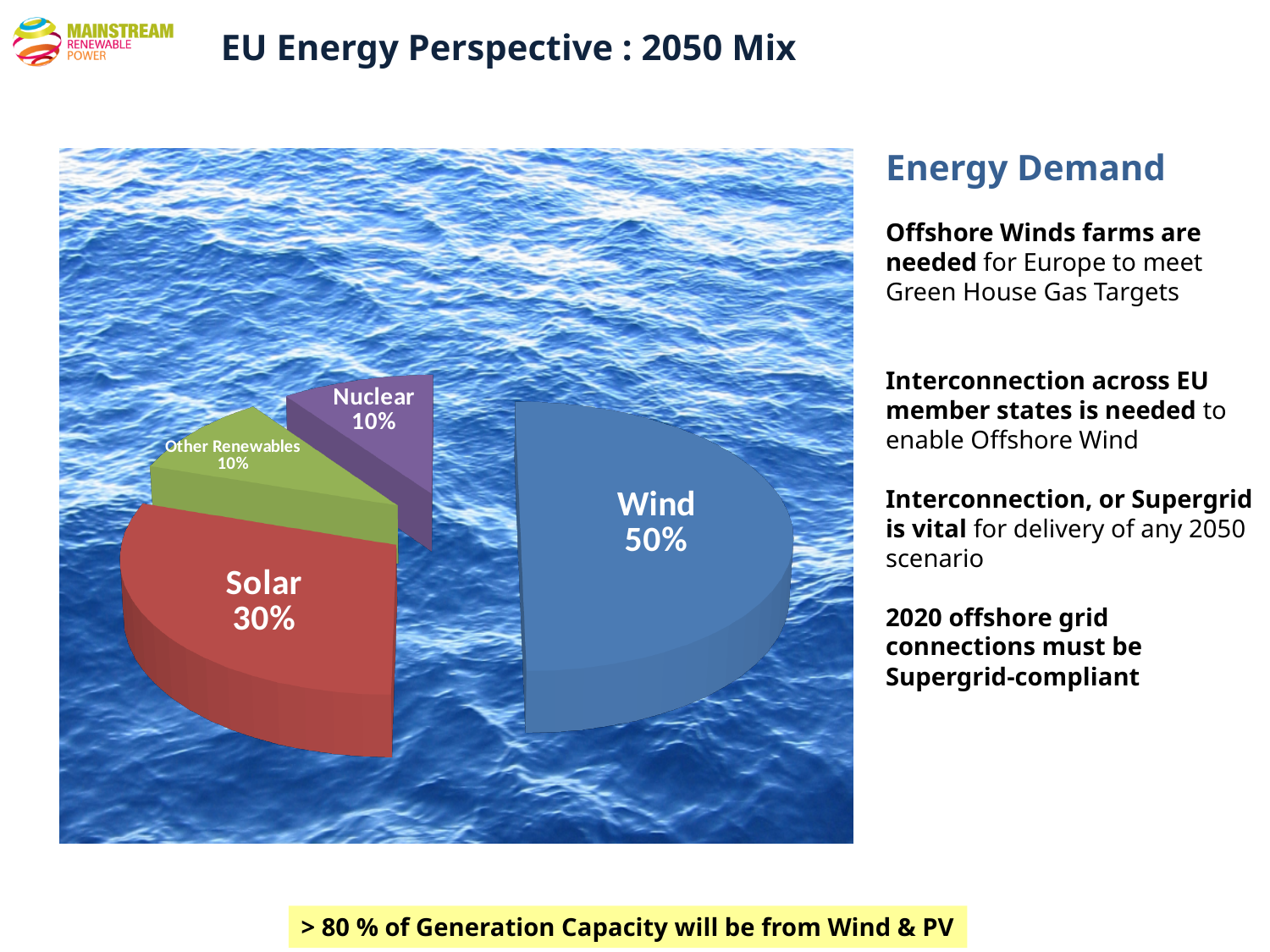
How many slices does the pie chart have? 4 What is the difference between the Wind share and the Solar share? 20% What share of the 2050 energy mix is Solar? 30% What share of the 2050 energy mix is Nuclear? 10% Which is larger, the Solar share or the Nuclear share? Solar What colour is the Wind slice? blue What kind of chart is shown on the slide? pie chart Which slice is pulled out from the rest of the pie? Wind Which category has the largest slice of the pie? Wind What share of the 2050 energy mix is Other Renewables? 10% What share of the 2050 energy mix is Wind? 50% What is the combined share of Wind and Solar? 80%